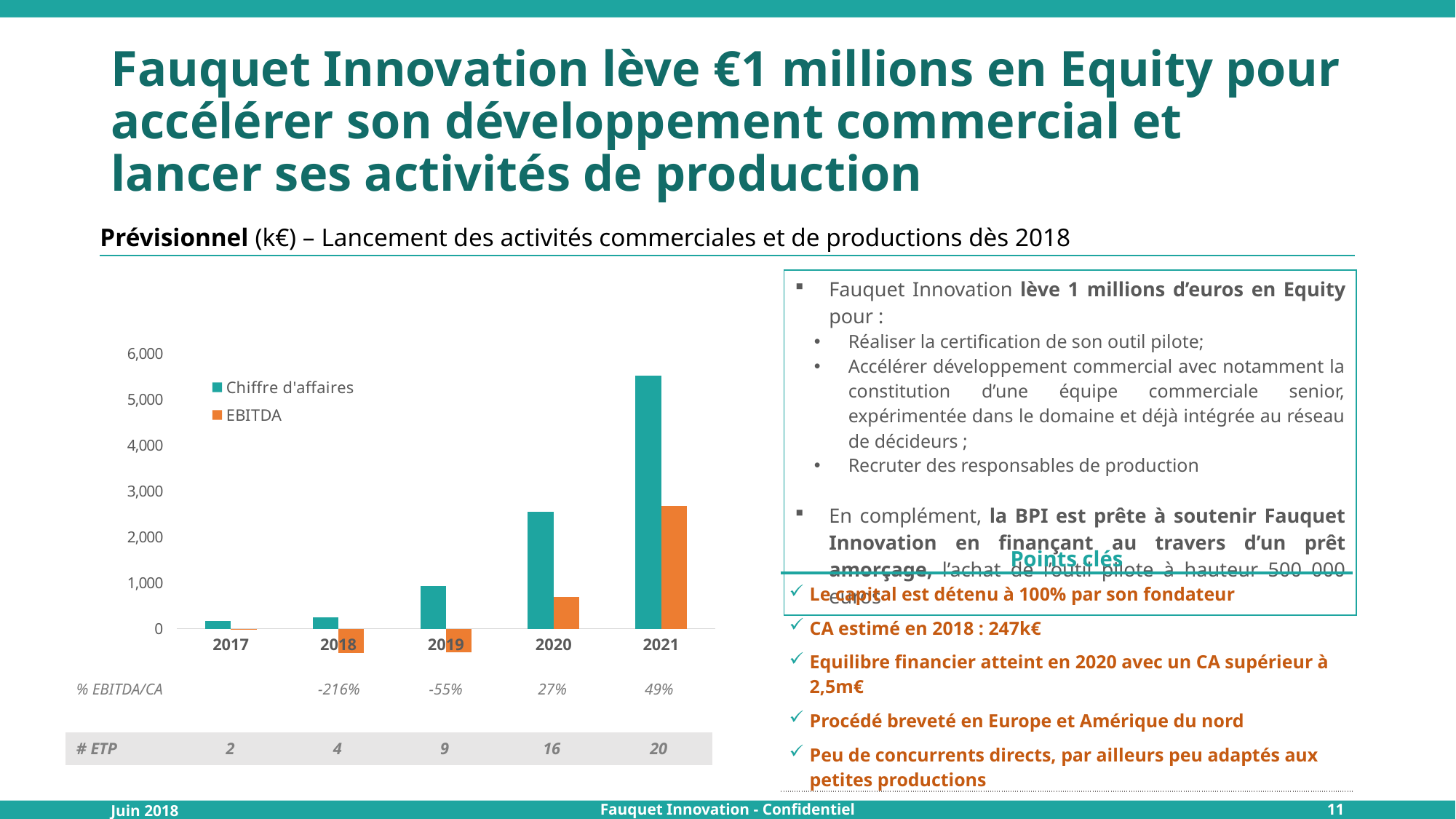
How many years are shown on the x axis of the chart? 5 Which is larger, Chiffre d'affaires in 2020 or Chiffre d'affaires in 2021? 2021 What are the two series named in the chart legend? Chiffre d'affaires and EBITDA Does Chiffre d'affaires rise or fall from 2017 to 2021? Rises In which year is Chiffre d'affaires highest? 2021 Is the Chiffre d'affaires value for 2020 greater or less than 2,000? greater Is the Chiffre d'affaires value for 2019 greater or less than 1,000? less Is the EBITDA value for 2021 greater or less than 3,000? less What kind of chart is shown on the slide? Bar chart In which year is Chiffre d'affaires lowest? 2017 How many series does the chart legend list? 2